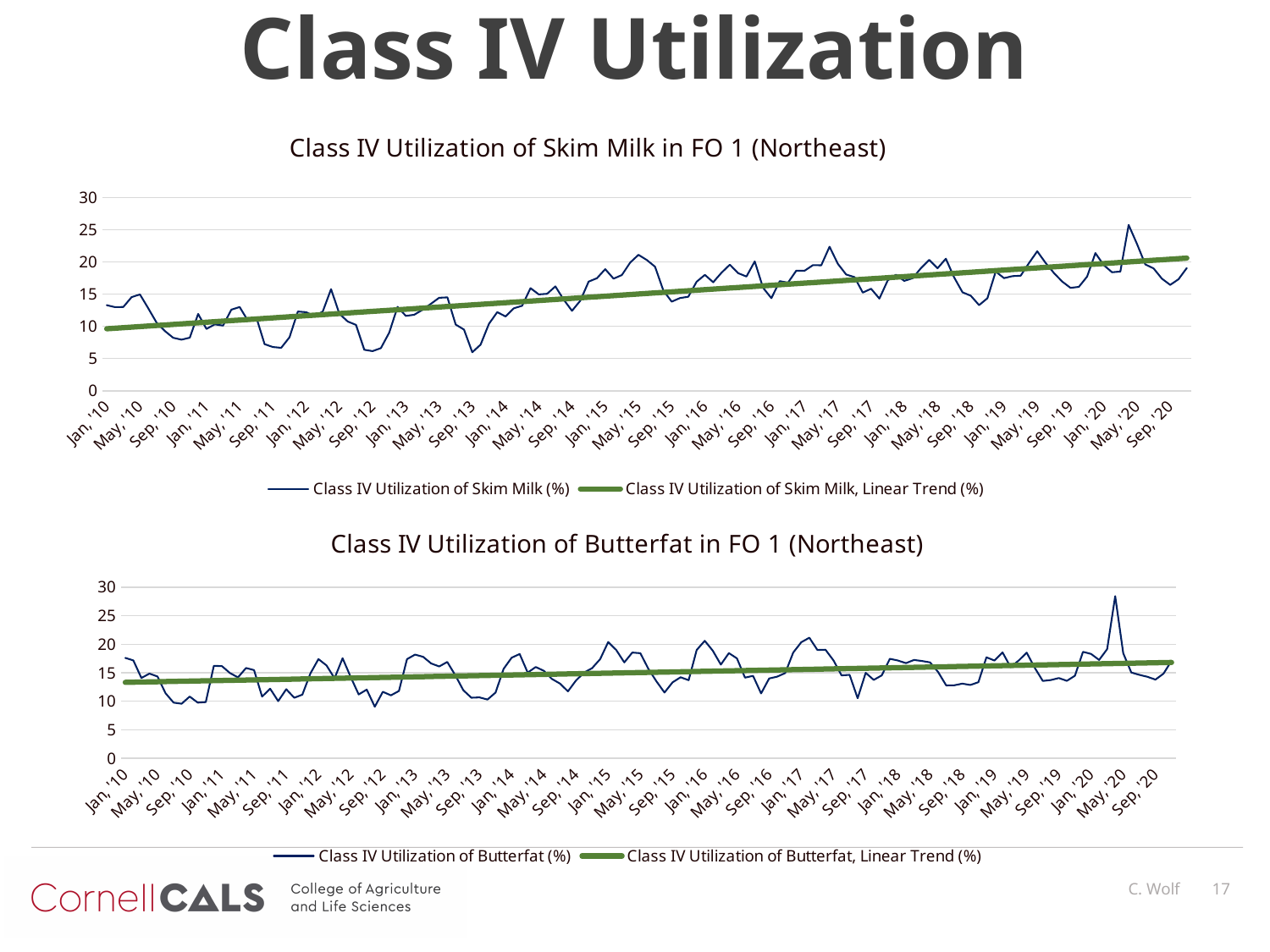
In the bottom chart (Butterfat), is the peak Class IV Utilization of Butterfat (%) value around May '20 greater or less than 25? greater How many series does the legend of the top chart (Skim Milk) list? 2 In the bottom chart (Butterfat), does the linear trend line rise or fall from Jan '10 to Sep '20? Rise What kind of chart is the top chart, 'Class IV Utilization of Skim Milk in FO 1 (Northeast)'? Line chart In the bottom chart (Butterfat), what colour is the linear trend line? Green In the top chart (Skim Milk), is the Class IV Utilization of Skim Milk (%) value at Sep '13 greater or less than 10? less What kind of chart is the bottom chart, 'Class IV Utilization of Butterfat in FO 1 (Northeast)'? Line chart In the top chart (Skim Milk), is the peak Class IV Utilization of Skim Milk (%) value around May '20 greater or less than 20? greater How many series does the legend of the bottom chart (Butterfat) list? 2 What is the title of the top chart on the slide? Class IV Utilization of Skim Milk in FO 1 (Northeast) In the top chart (Skim Milk), does the linear trend line rise or fall from Jan '10 to Sep '20? Rise